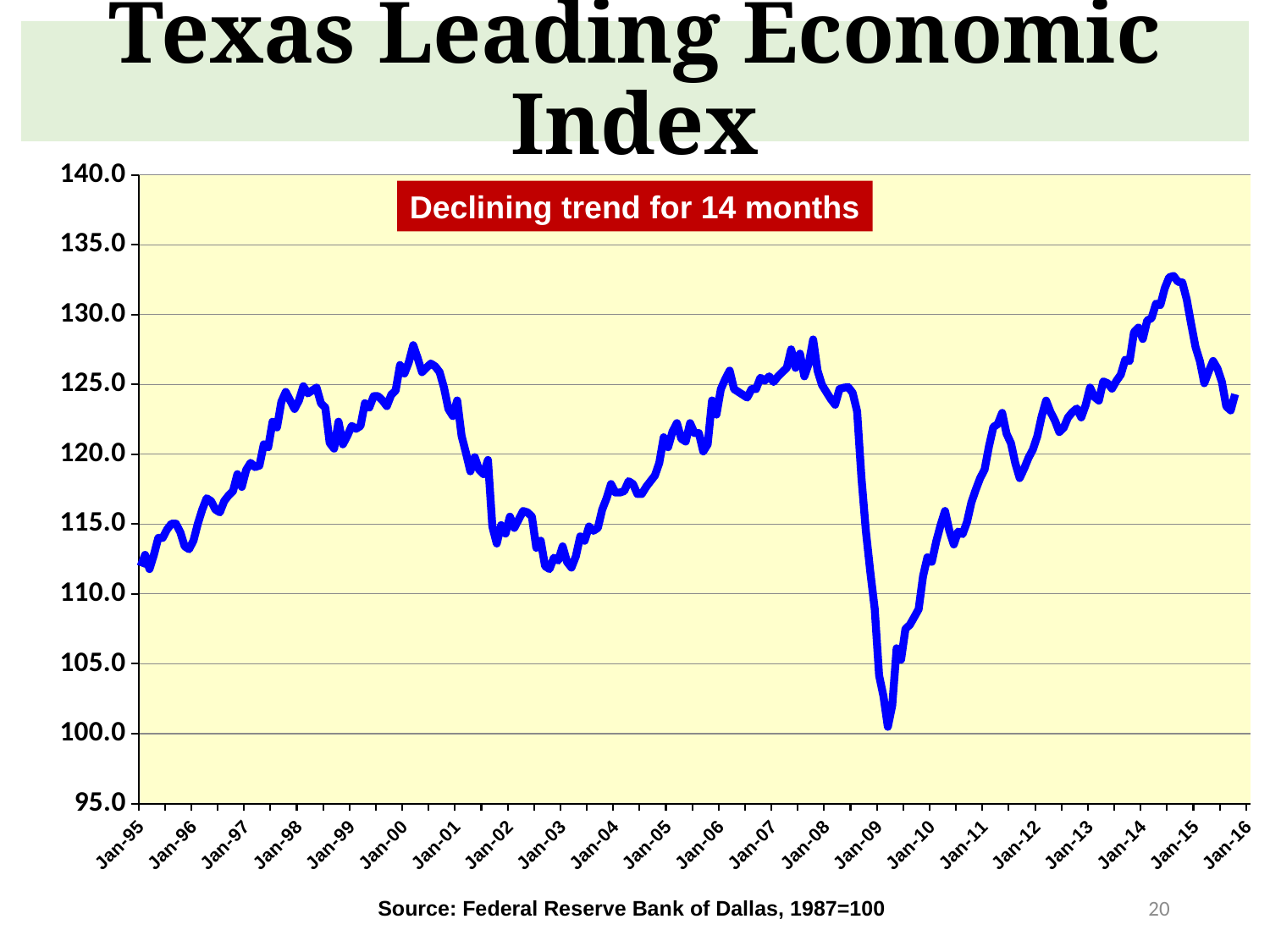
How many date labels are shown on the x axis? 22 What is the title of the chart on the slide? Texas Leading Economic Index What kind of chart is shown on the slide? line chart What does the red annotation box on the chart say? Declining trend for 14 months Is the lowest point of the index line greater or less than 105? less Near which x-axis label does the index reach its lowest point? Jan-09 Does the index rise or fall between Jan-15 and Jan-16? fall How many lines are plotted on the chart? 1 Is the value of the index at Jan-03 greater or less than 115? less Is the value of the index at Jan-95 greater or less than 115? less